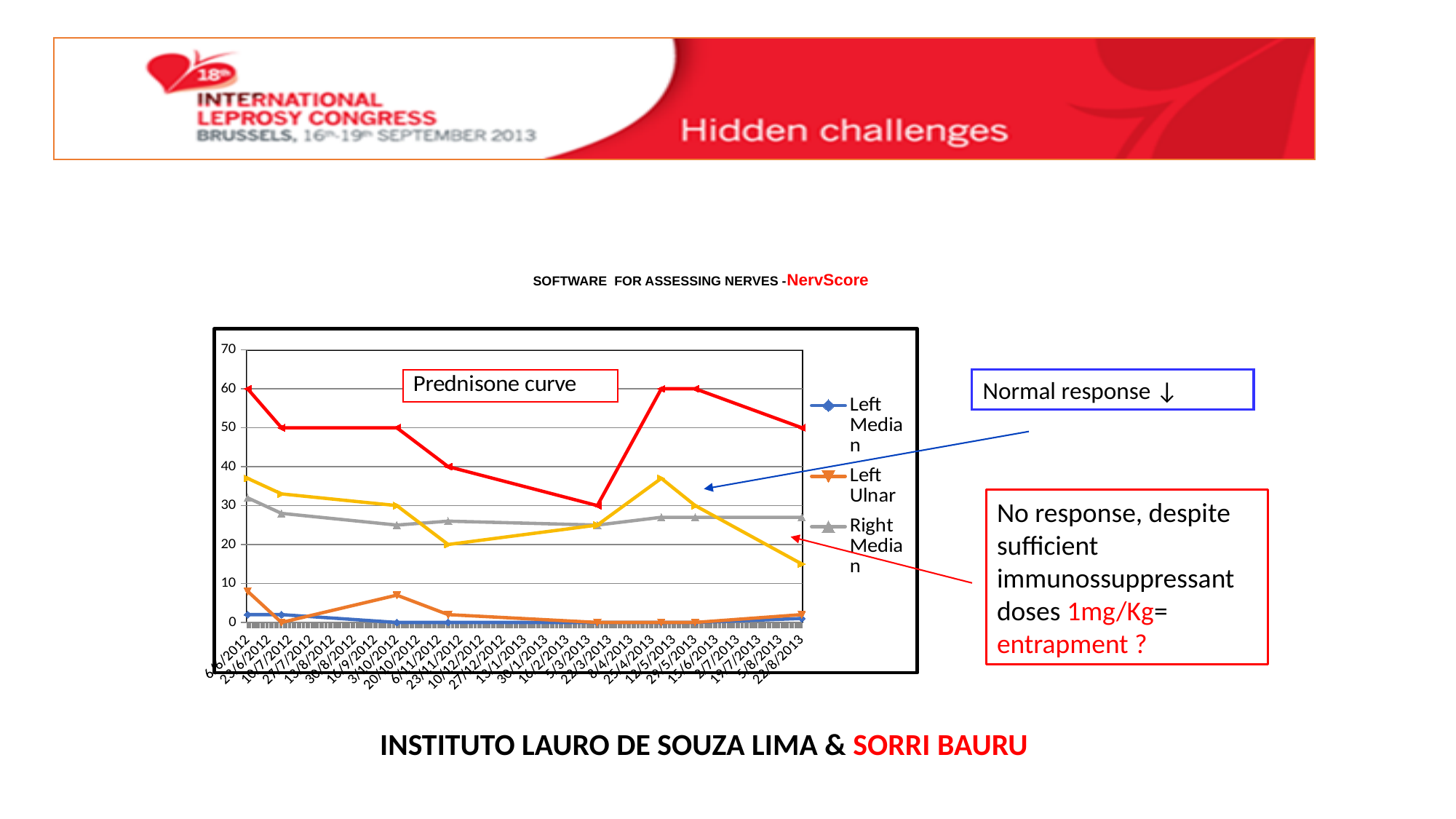
Is the Right Median line greater or less than 40 across the whole period? less Which series is drawn in orange? Left Ulnar What is the maximum value shown on the vertical axis? 70 What is the lowest value reached by the red Prednisone curve? 30 What is the value of the red Prednisone curve at the first date on the x axis? 60 What label is written in the box inside the plot area? Prednisone curve Which series is higher throughout the period, Right Median or Left Ulnar? Right Median What kind of chart is shown on the slide? Line chart What is the highest value reached by the red Prednisone curve? 60 Does the yellow line rise or fall between its peak in 2013 and the last date on the x axis? Fall How many series does the visible legend list? 3 Is the Left Median line greater or less than 10 across the whole period? less